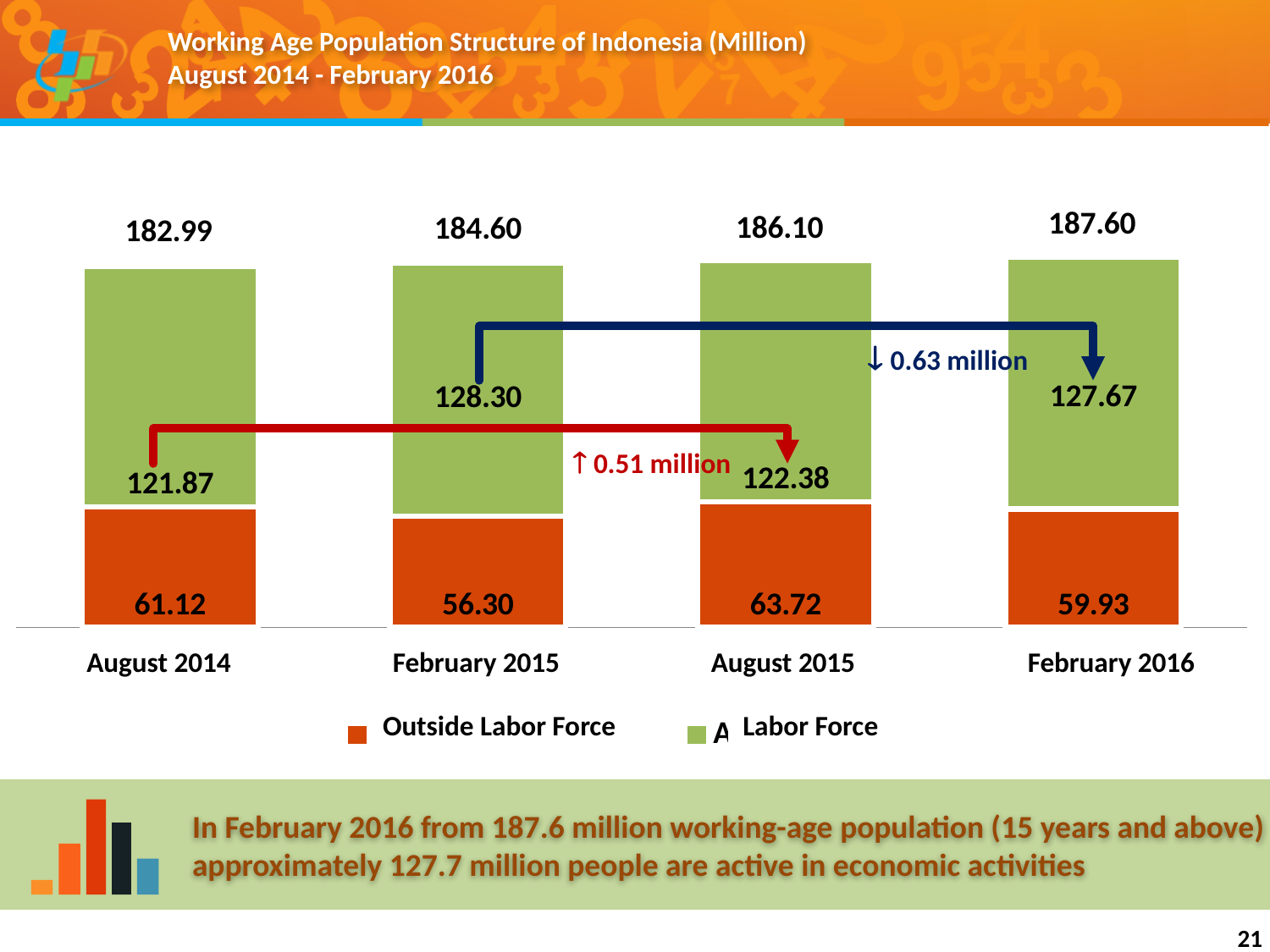
What is the total working age population shown for August 2015? 186.10 Which period has the lowest Outside Labor Force value? February 2015 What is the difference between the Outside Labor Force values for August 2015 and February 2015? 7.42 Do the total working age population values rise or fall from August 2014 to February 2016? Rise Which period has the highest Labor Force value? February 2015 What is the Labor Force value for August 2014? 121.87 What is the Labor Force value for February 2016? 127.67 Is the Labor Force value larger in February 2015 or in August 2015? February 2015 What kind of chart is shown on the slide? Stacked bar chart What is the Outside Labor Force value for August 2015? 63.72 How many series does the legend list? 2 How many periods are shown on the x axis? 4